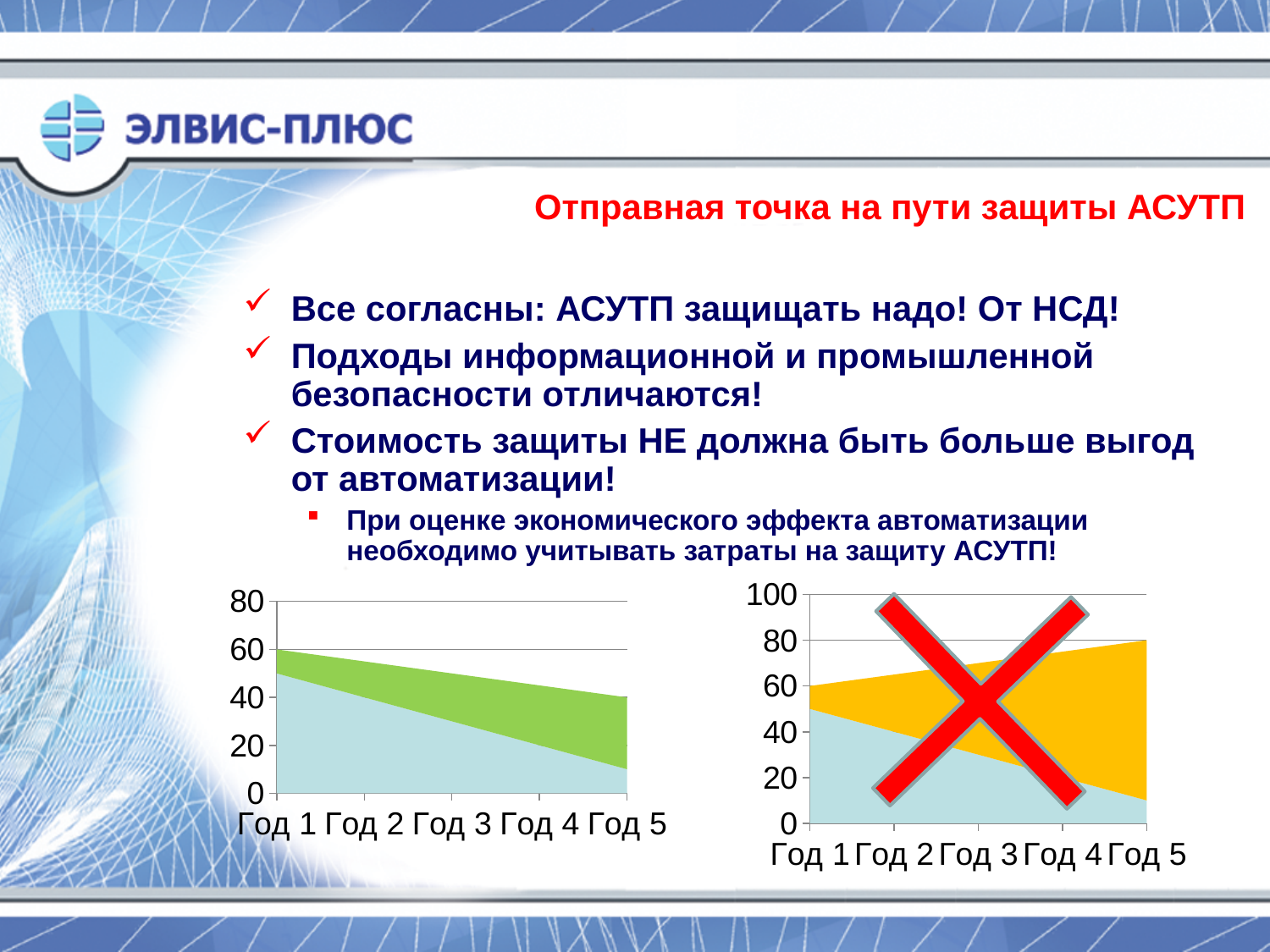
What kind of chart is the chart on the right side of the slide? area chart In the left chart, does the light blue area rise or fall from Год 1 to Год 5? fall What is the highest value shown on the y axis of the left chart? 80 In the right chart, is the value of the light blue area at Год 5 greater or less than 20? less What is the highest value shown on the y axis of the right chart? 100 What kind of chart is the chart on the left side of the slide? area chart How many categories are shown on the x axis of the right chart? 5 In the right chart, does the top of the orange area rise or fall from Год 1 to Год 5? rise How many categories are shown on the x axis of the left chart? 5 In the left chart, is the value of the light blue area at Год 1 greater or less than 40? greater In the left chart, is the value of the light blue area at Год 5 greater or less than 20? less